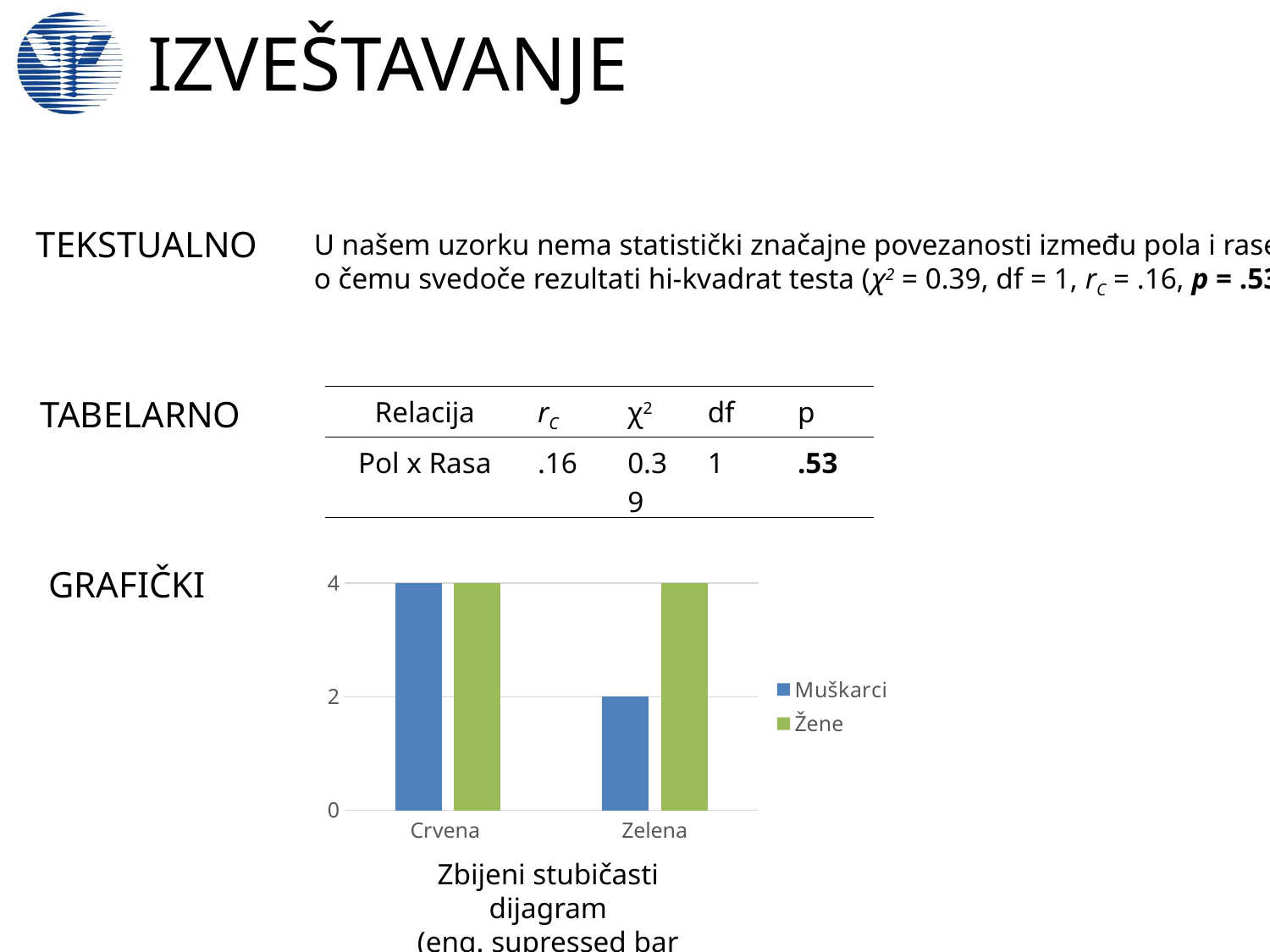
What is the value for Žene in the Zelena category? 4 In the Zelena category, which series has the larger value, Muškarci or Žene? Žene What kind of chart is shown on the slide? bar chart What is the difference between the Žene and Muškarci values in the Zelena category? 2 Which series is shown in green in the chart? Žene Which series is shown in blue in the chart? Muškarci How many categories are shown on the x axis of the chart? 2 What is the value for Muškarci in the Zelena category? 2 What is the value for Muškarci in the Crvena category? 4 How many series does the chart legend list? 2 What is the value for Žene in the Crvena category? 4 In which category is the value for Muškarci lowest? Zelena